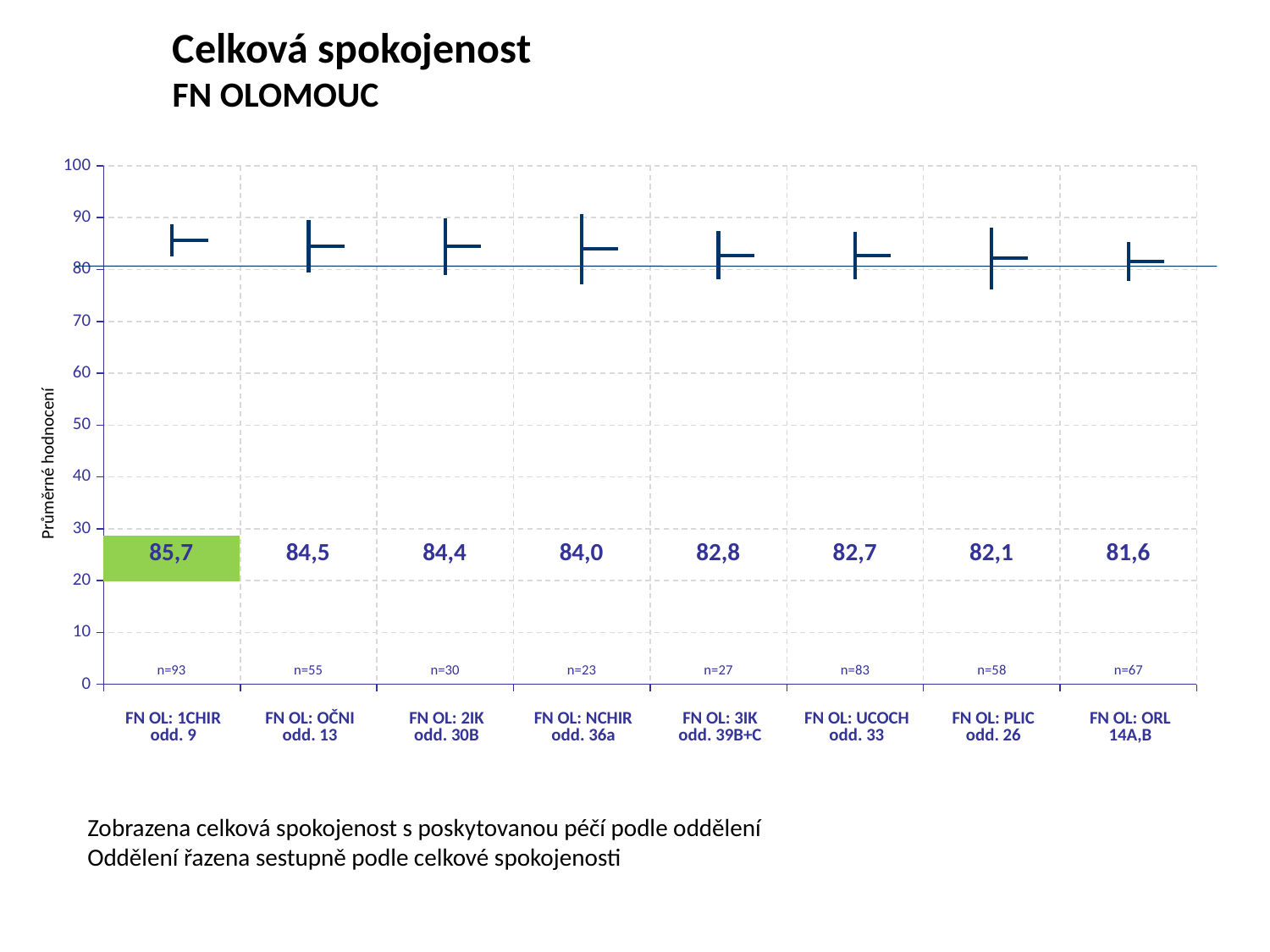
Which has a higher average rating, FN OL: OČNI odd. 13 or FN OL: PLIC odd. 26? FN OL: OČNI odd. 13 Which department has the highest average rating? FN OL: 1CHIR odd. 9 What is the difference between the average ratings of FN OL: 1CHIR odd. 9 and FN OL: ORL 14A,B? 4,1 What is the average rating for FN OL: ORL 14A,B? 81,6 What is the number of respondents (n) for FN OL: UCOCH odd. 33? n=83 Do the average ratings rise or fall from left to right along the x axis? fall Which department has the lowest average rating? FN OL: ORL 14A,B What is the average rating (průměrné hodnocení) for FN OL: 1CHIR odd. 9? 85,7 What is the average rating for FN OL: NCHIR odd. 36a? 84,0 How many departments are shown on the chart? 8 Is the average rating for FN OL: 3IK odd. 39B+C greater or less than 80? greater What is the title of the chart? Celková spokojenost FN OLOMOUC